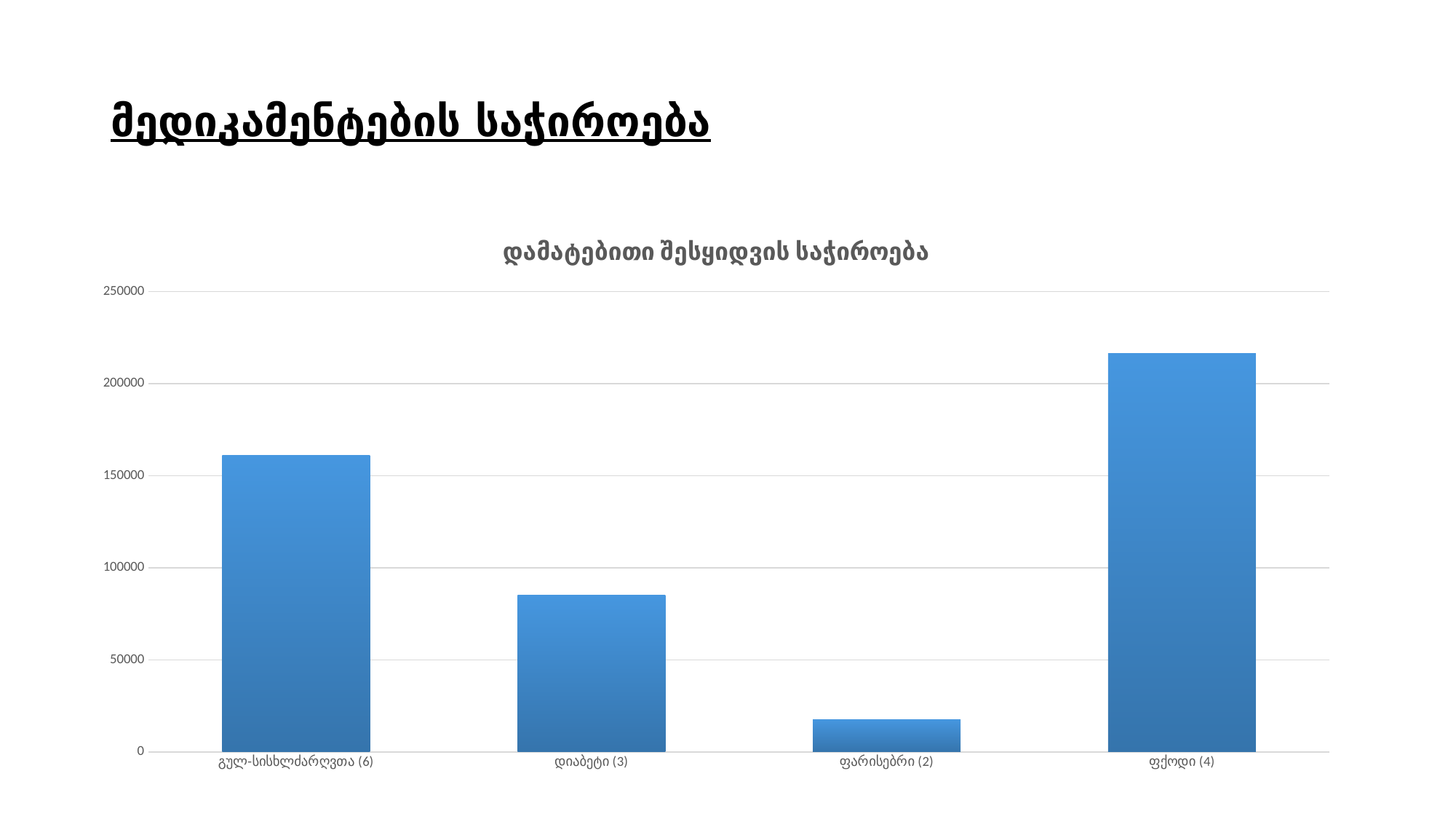
What is the highest value shown on the vertical axis of the chart? 250000 Is the value for დიაბეტი (3) greater or less than 100000? less Is the value for ფქოდი (4) greater or less than 200000? greater What kind of chart is shown on the slide? bar chart Is the value for ფარისებრი (2) greater or less than 50000? less What is the title of the chart? დამატებითი შესყიდვის საჭიროება Which is larger: the value for ფქოდი (4) or the value for გულ-სისხლძარღვთა (6)? ფქოდი (4) Which is larger: the value for გულ-სისხლძარღვთა (6) or the value for დიაბეტი (3)? გულ-სისხლძარღვთა (6) Which category has the highest value in the chart? ფქოდი (4) How many categories are shown on the x axis of the chart? 4 Which category has the lowest value in the chart? ფარისებრი (2)